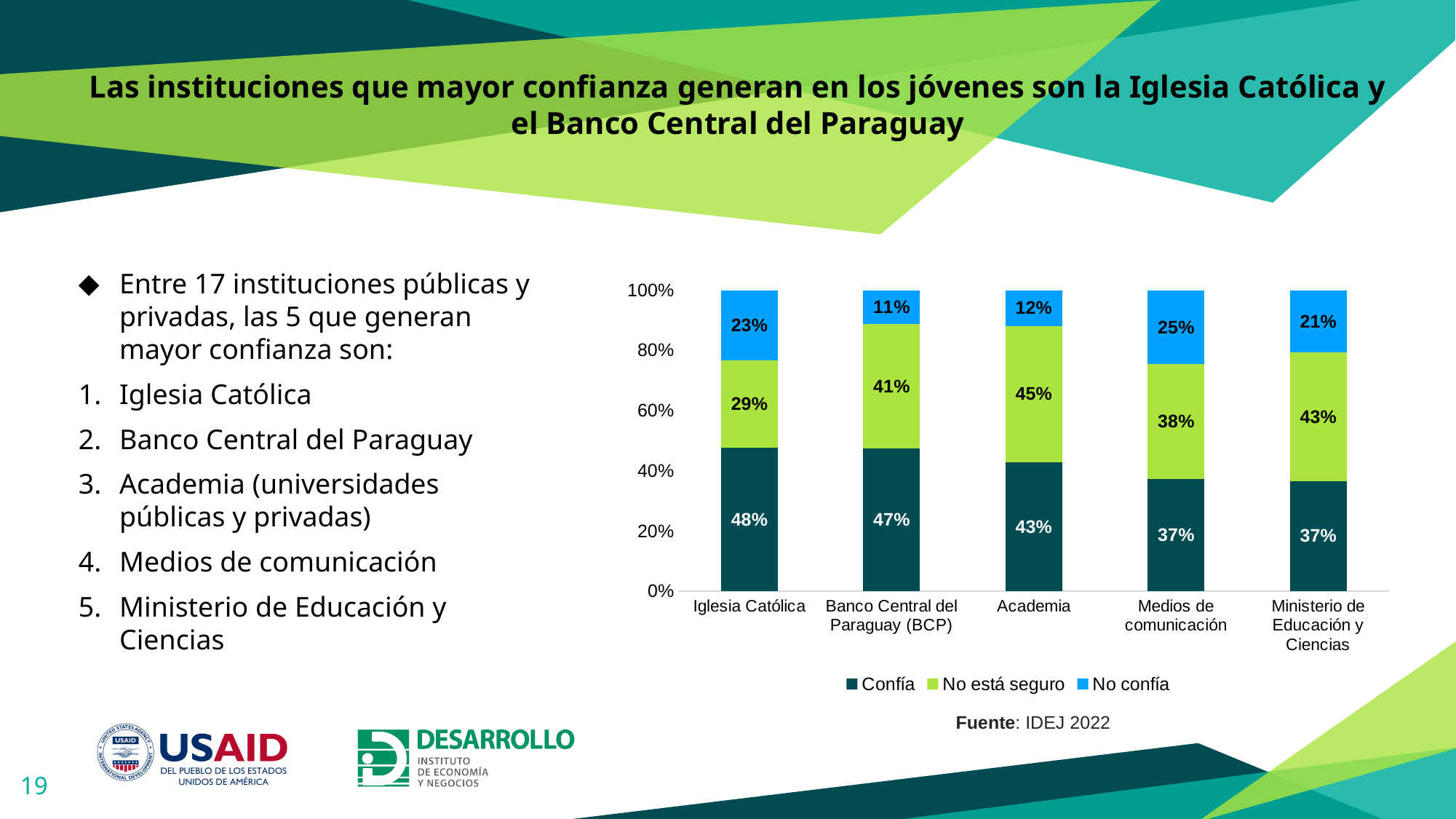
How many series does the chart legend list? 3 What kind of chart is shown on the slide? Stacked bar chart Which institution has the lowest "No confía" percentage? Banco Central del Paraguay (BCP) What is the difference in the "Confía" percentage between Iglesia Católica and Academia? 5 percentage points What is the "No confía" value for Banco Central del Paraguay (BCP)? 11% What percentage of young people say they trust ("Confía") the Iglesia Católica? 48% Which has a larger "No está seguro" share, Academia or Banco Central del Paraguay (BCP)? Academia What is the "No está seguro" value for Ministerio de Educación y Ciencias? 43% How many institutions are shown on the x axis of the chart? 5 Which institution has the highest "Confía" percentage? Iglesia Católica What is the difference in the "No confía" percentage between Medios de comunicación and Banco Central del Paraguay (BCP)? 14 percentage points Which institution has the highest "No está seguro" percentage? Academia